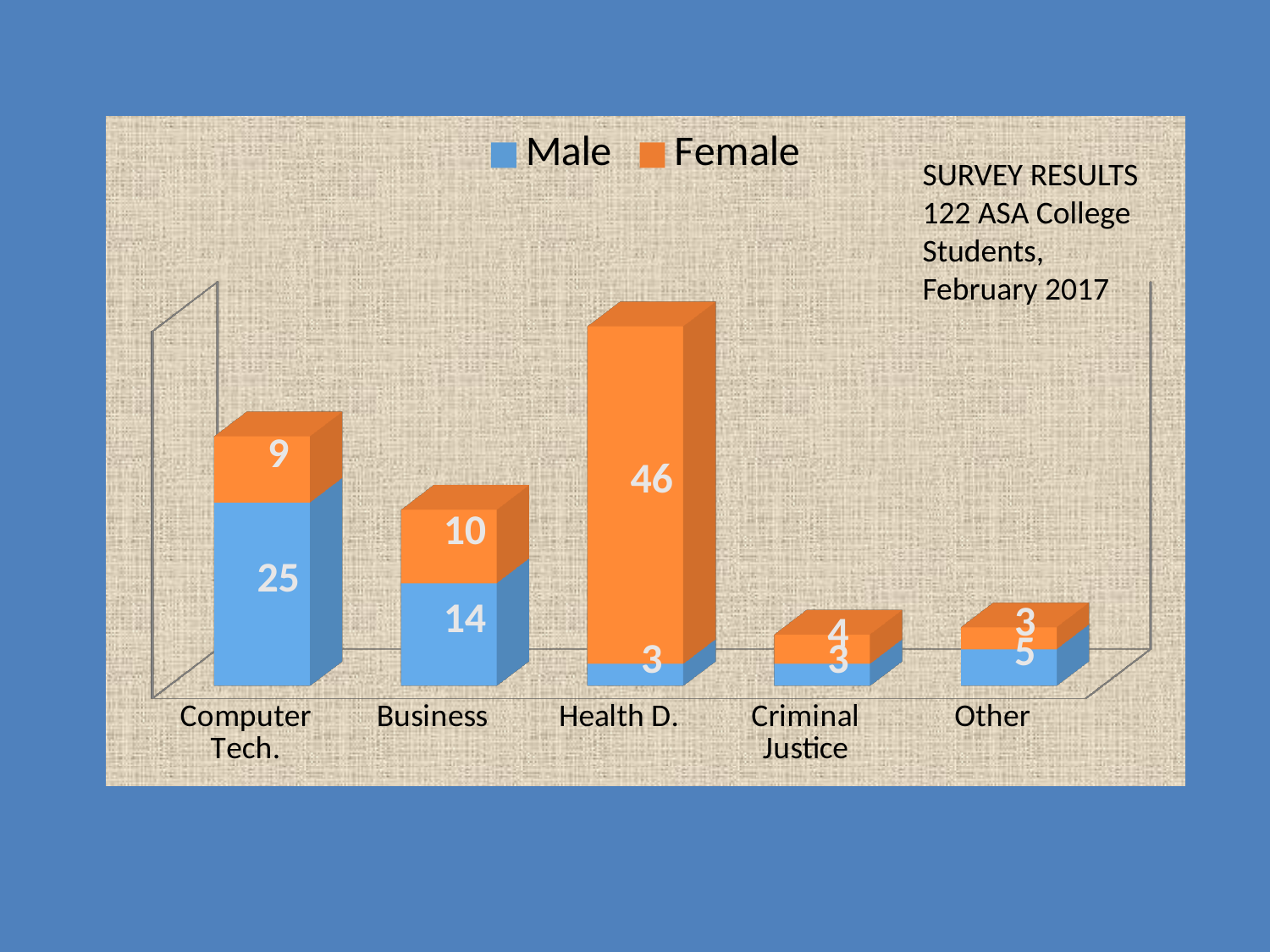
How many categories are shown on the x axis? 5 What kind of chart is shown on the slide? Stacked bar chart What is the Male value for Other? 5 Which category has the highest Male value? Computer Tech. Which category has the highest Female value? Health D. What is the Male value for Computer Tech.? 25 What is the Female value for Business? 10 What is the Female value for Health D.? 46 How many series does the legend list? 2 Which is larger, the Male value for Business or the Male value for Health D.? Male value for Business What is the total of the stacked bar for Business? 24 What is the difference between the Male and Female values for Computer Tech.? 16